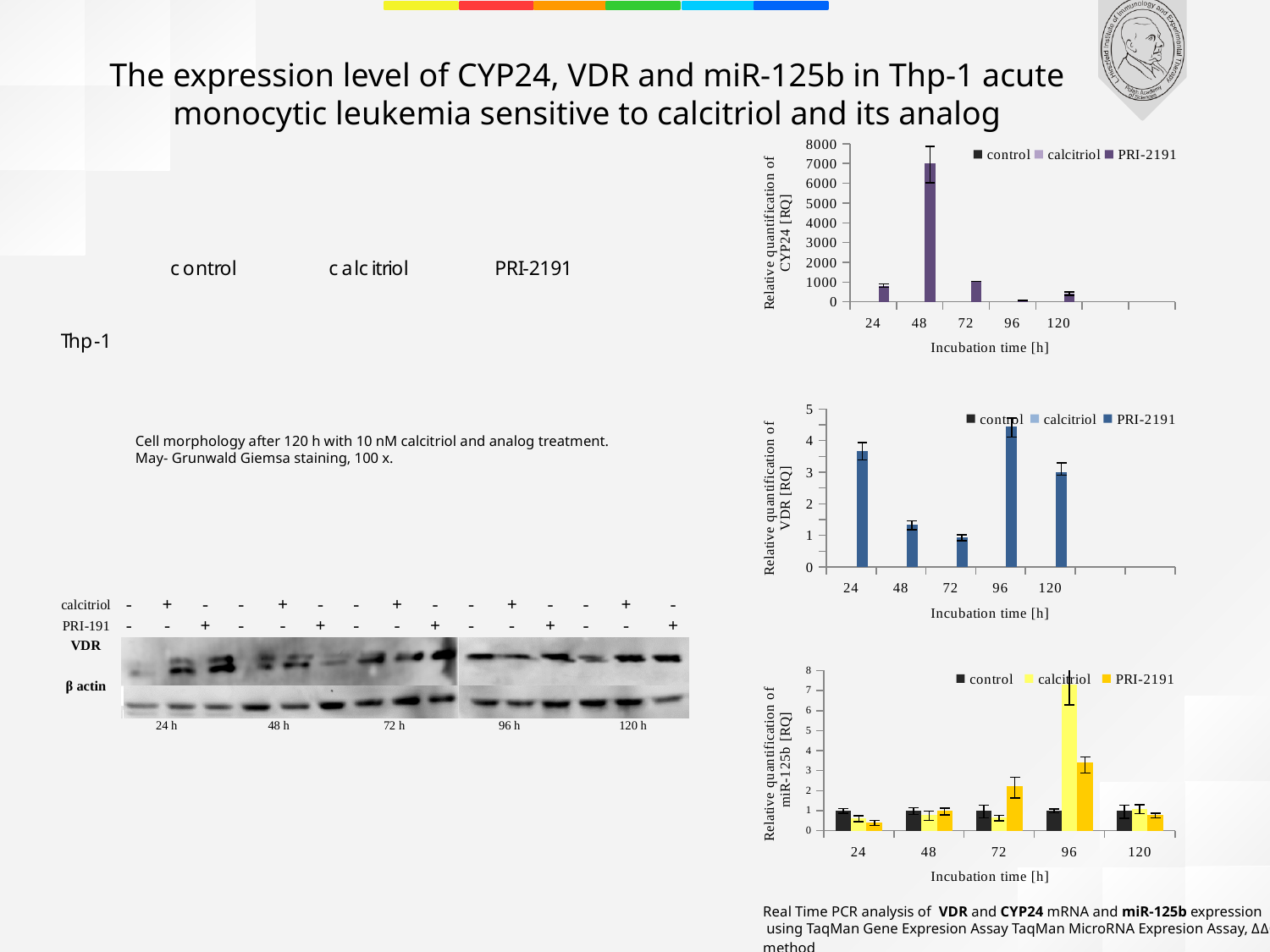
What is the x-axis label of the bottom miR-125b chart? Incubation time [h] In the middle VDR chart, is the value at 24 h greater or less than 3? greater In the top CYP24 chart, is the PRI-2191 value at 48 h greater or less than 6000? greater In the middle VDR chart, at which incubation time is the bar highest? 96 How many series does the legend of the top CYP24 chart list? 3 How many incubation time points are shown on the x axis of the middle VDR chart? 5 In the bottom miR-125b chart, is the calcitriol value at 96 h greater or less than 6? greater What kind of chart is the top chart (Relative quantification of CYP24 [RQ])? bar chart In the top CYP24 chart, at which incubation time is the PRI-2191 bar highest? 48 In the bottom miR-125b chart, which series has the tallest bar at 96 h? calcitriol In the middle VDR chart, at which incubation time is the bar lowest? 72